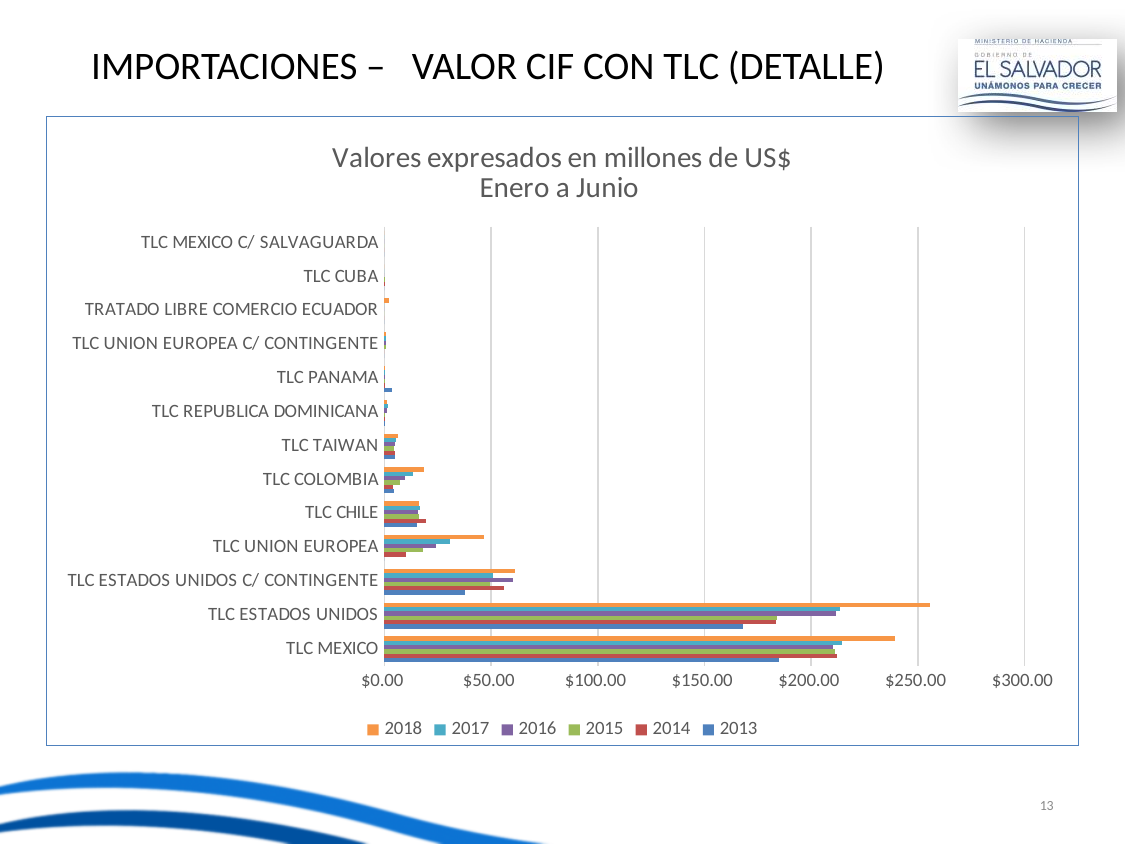
Which category has the highest value for 2018? TLC ESTADOS UNIDOS Is the 2018 value for TLC MEXICO greater or less than $200.00? greater For 2018, which is larger: TLC ESTADOS UNIDOS or TLC MEXICO? TLC ESTADOS UNIDOS Which category shows the smallest values across all years? TLC MEXICO C/ SALVAGUARDA How many TLC categories are listed on the vertical axis? 13 Is the 2018 value for TLC ESTADOS UNIDOS C/ CONTINGENTE greater or less than $100.00? less Is the 2018 value for TLC CHILE greater or less than $50.00? less For 2018, which is larger: TLC ESTADOS UNIDOS C/ CONTINGENTE or TLC UNION EUROPEA? TLC ESTADOS UNIDOS C/ CONTINGENTE What is the title of the chart? Valores expresados en millones de US$ Enero a Junio What kind of chart is shown on the slide? Bar chart How many series does the legend list? 6